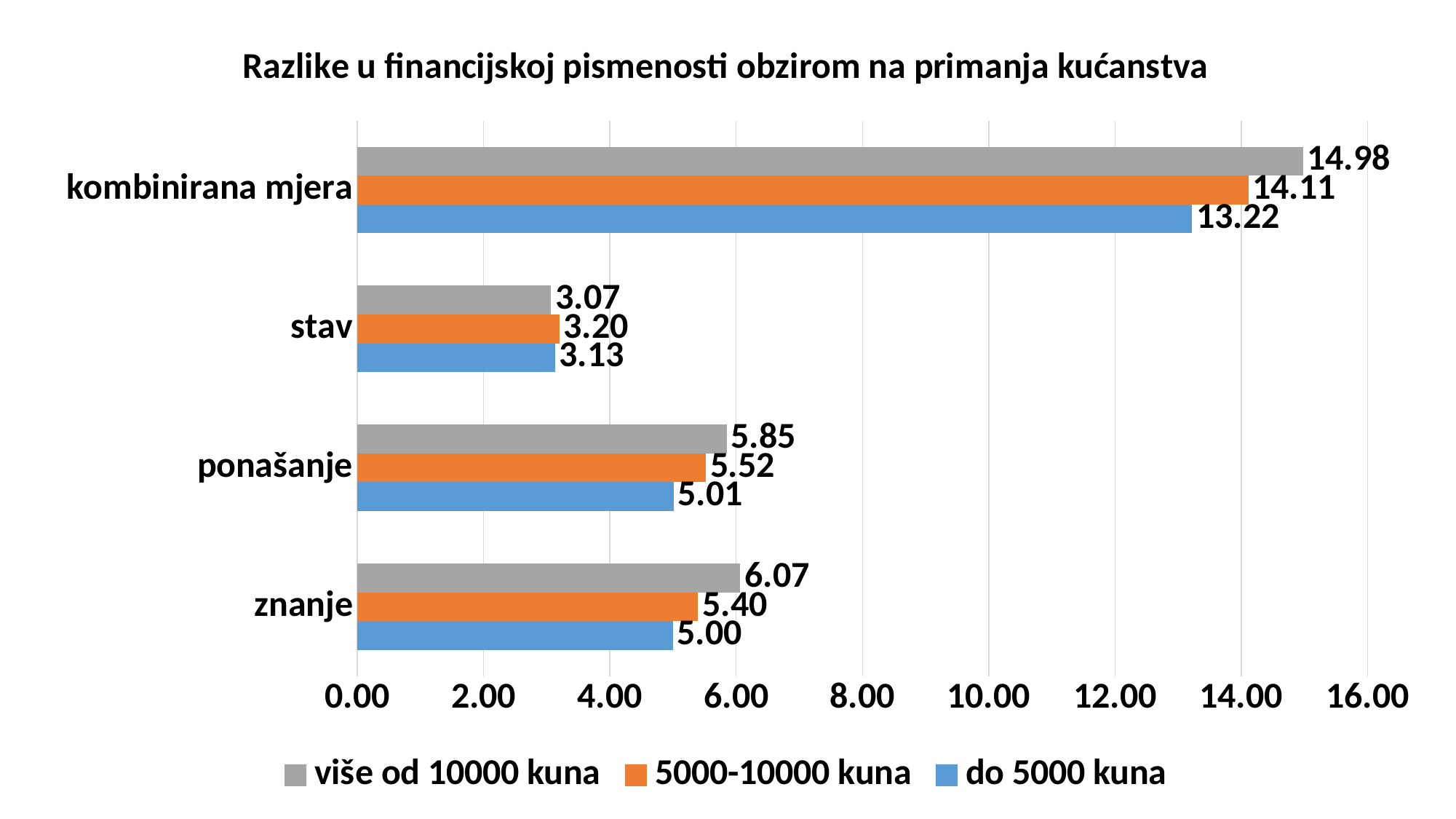
For 'ponašanje', which is larger: the 'više od 10000 kuna' value or the 'do 5000 kuna' value? više od 10000 kuna Which category has the highest value in the 'do 5000 kuna' series? kombinirana mjera Which category has the lowest value in the 'više od 10000 kuna' series? stav What kind of chart is shown on the slide? bar chart What is the difference between the 'više od 10000 kuna' and 'do 5000 kuna' values for 'kombinirana mjera'? 1.76 What is the value for 'znanje' in the 'do 5000 kuna' series? 5.00 What is the title of the chart? Razlike u financijskoj pismenosti obzirom na primanja kućanstva What is the difference between the 'više od 10000 kuna' and '5000-10000 kuna' values for 'znanje'? 0.67 How many categories are shown on the chart? 4 How many series does the legend list? 3 What is the value for 'stav' in the '5000-10000 kuna' series? 3.20 What is the value for 'kombinirana mjera' in the 'više od 10000 kuna' series? 14.98